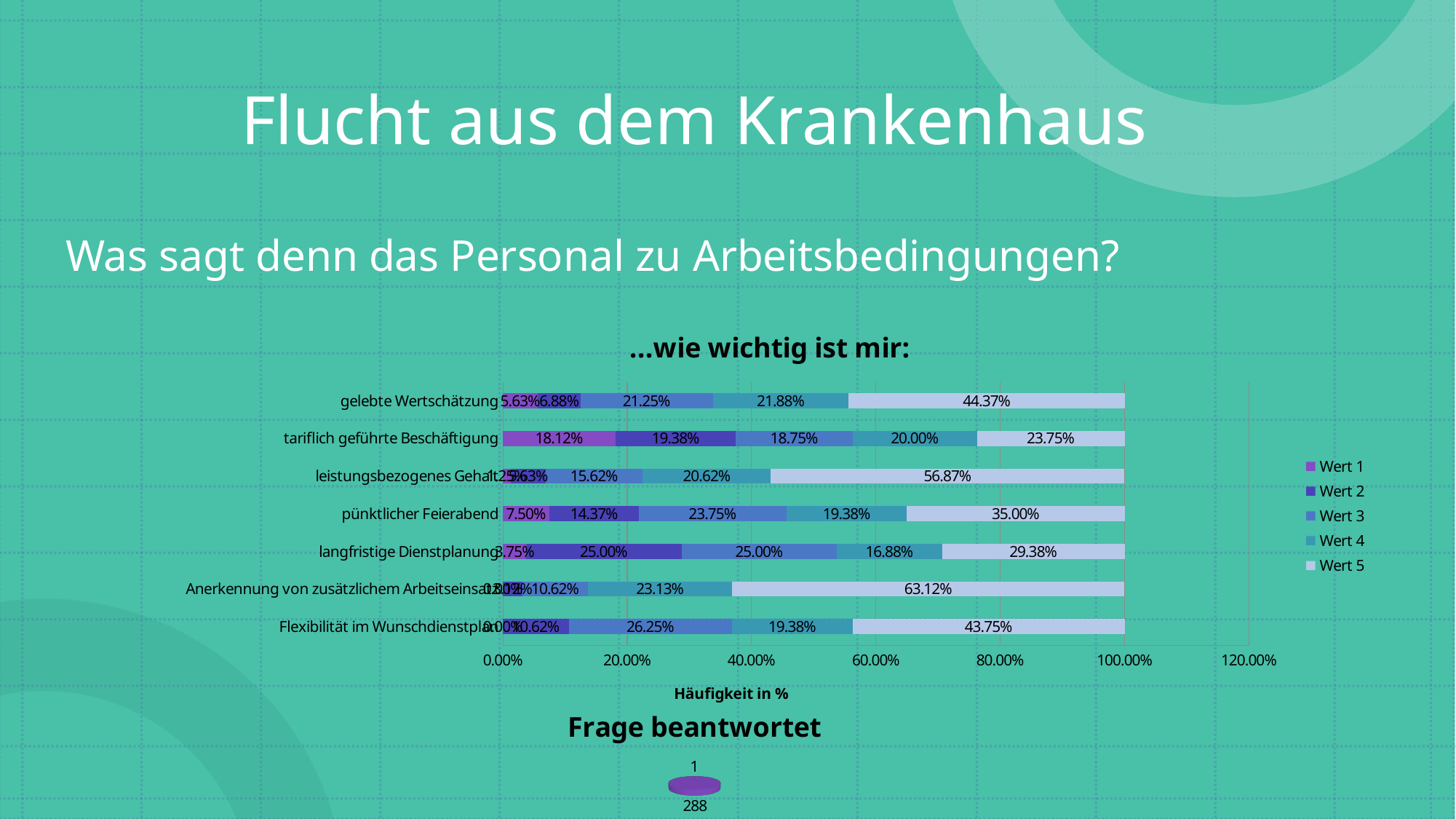
In the "...wie wichtig ist mir:" chart, what is the Wert 4 value for "langfristige Dienstplanung"? 16.88% What kind of chart is the "...wie wichtig ist mir:" chart? stacked bar chart What is the x-axis label of the "...wie wichtig ist mir:" chart? Häufigkeit in % In the "...wie wichtig ist mir:" chart, which category has the highest Wert 5 value? Anerkennung von zusätzlichem Arbeitseinsatz In the "...wie wichtig ist mir:" chart, what is the Wert 1 value for "tariflich geführte Beschäftigung"? 18.12% In the "...wie wichtig ist mir:" chart, what is the Wert 5 value for "gelebte Wertschätzung"? 44.37% In the "...wie wichtig ist mir:" chart, what is the difference between the Wert 5 values for "Flexibilität im Wunschdienstplan" and "pünktlicher Feierabend"? 8.75% In the "...wie wichtig ist mir:" chart, what is the Wert 3 value for "pünktlicher Feierabend"? 23.75% How many series does the legend of the "...wie wichtig ist mir:" chart list? 5 How many categories are shown on the y axis of the "...wie wichtig ist mir:" chart? 7 In the "...wie wichtig ist mir:" chart, which is larger: the Wert 2 value for "langfristige Dienstplanung" or the Wert 2 value for "pünktlicher Feierabend"? langfristige Dienstplanung In the "...wie wichtig ist mir:" chart, which category has the lowest Wert 5 value? tariflich geführte Beschäftigung